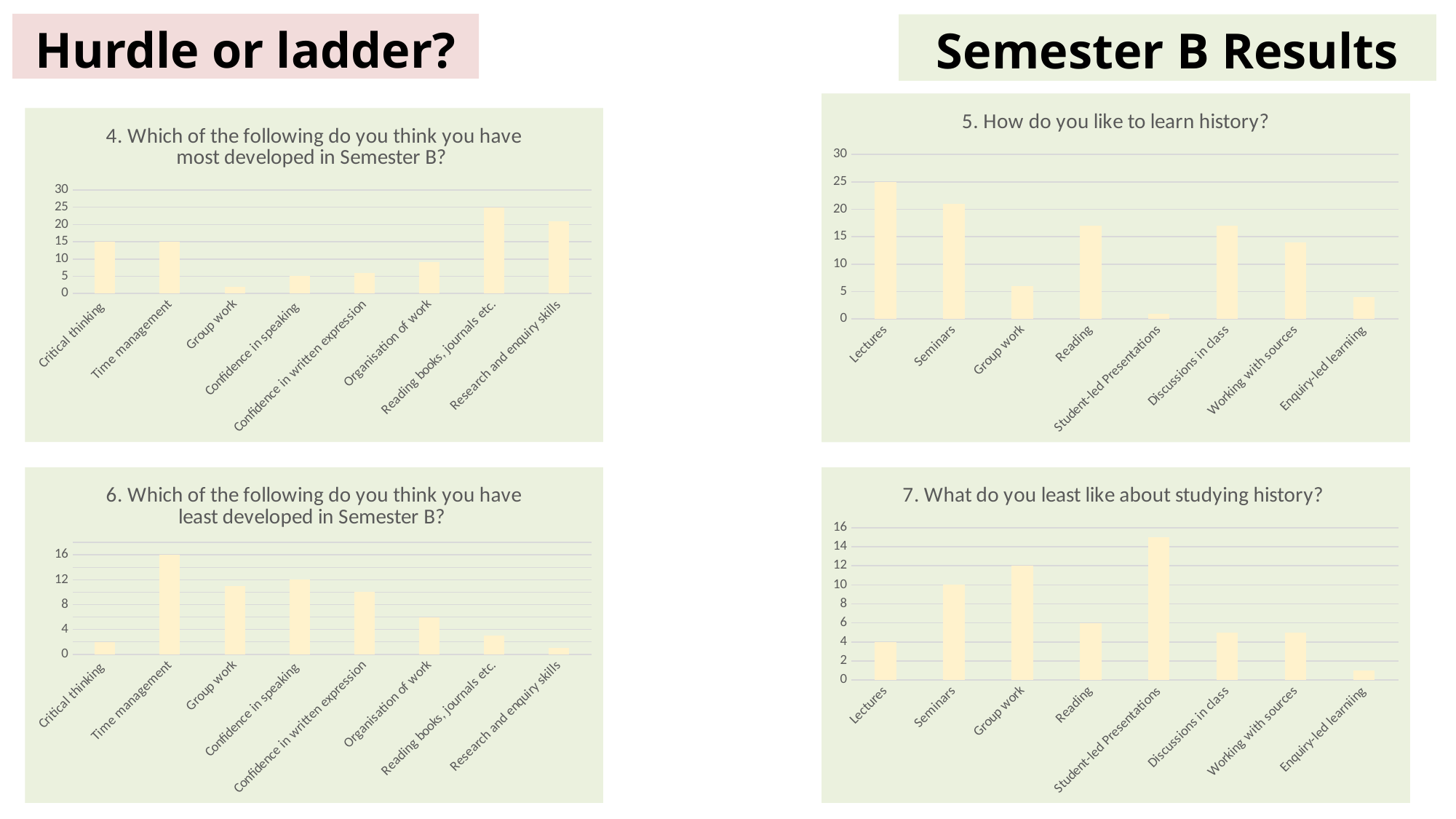
In the chart titled '5. How do you like to learn history?', which category has the lowest value? Student-led Presentations In the chart titled '5. How do you like to learn history?', is the value for Seminars greater or less than 20? greater In the chart titled '7. What do you least like about studying history?', which category has the highest value? Student-led Presentations In the chart titled '5. How do you like to learn history?', which category has the highest value? Lectures In the chart titled '6. Which of the following do you think you have least developed in Semester B?', what is the value for Time management? 16 In the chart titled '4. Which of the following do you think you have most developed in Semester B?', which category has the lowest value? Group work In the chart titled '7. What do you least like about studying history?', what is the value for Group work? 12 How many categories are shown in the chart titled '5. How do you like to learn history?'? 8 In the chart titled '4. Which of the following do you think you have most developed in Semester B?', what is the value for Reading books, journals etc.? 25 In the chart titled '7. What do you least like about studying history?', which is larger, the value for Seminars or the value for Reading? Seminars In the chart titled '6. Which of the following do you think you have least developed in Semester B?', which category has the highest value? Time management